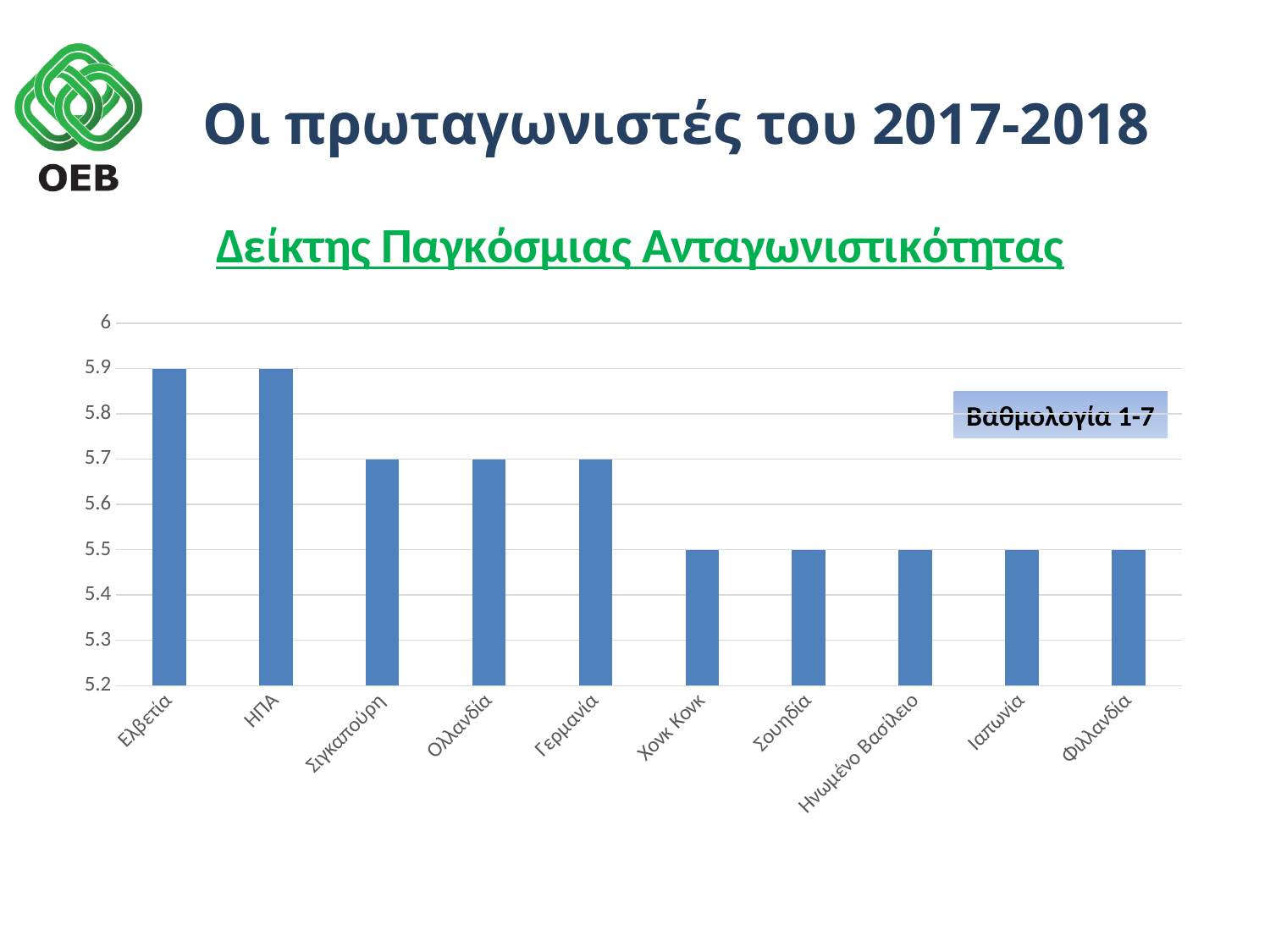
Is the value for Γερμανία greater or less than 5.6? greater What is the value for Ιαπωνία? 5.5 What kind of chart is shown on the slide? bar chart Which is larger, the value for Σουηδία or the value for Ολλανδία? Ολλανδία Which is larger, the value for ΗΠΑ or the value for Χονκ Κονκ? ΗΠΑ What is the value for Γερμανία? 5.7 How many countries are shown in the chart? 10 Do the values rise or fall from left to right along the x axis? fall What is the value for Σιγκαπούρη? 5.7 What is the value for Ελβετία? 5.9 What is the difference between the values for Ελβετία and Φινλανδία? 0.4 What is the difference between the values for Ολλανδία and Ηνωμένο Βασίλειο? 0.2